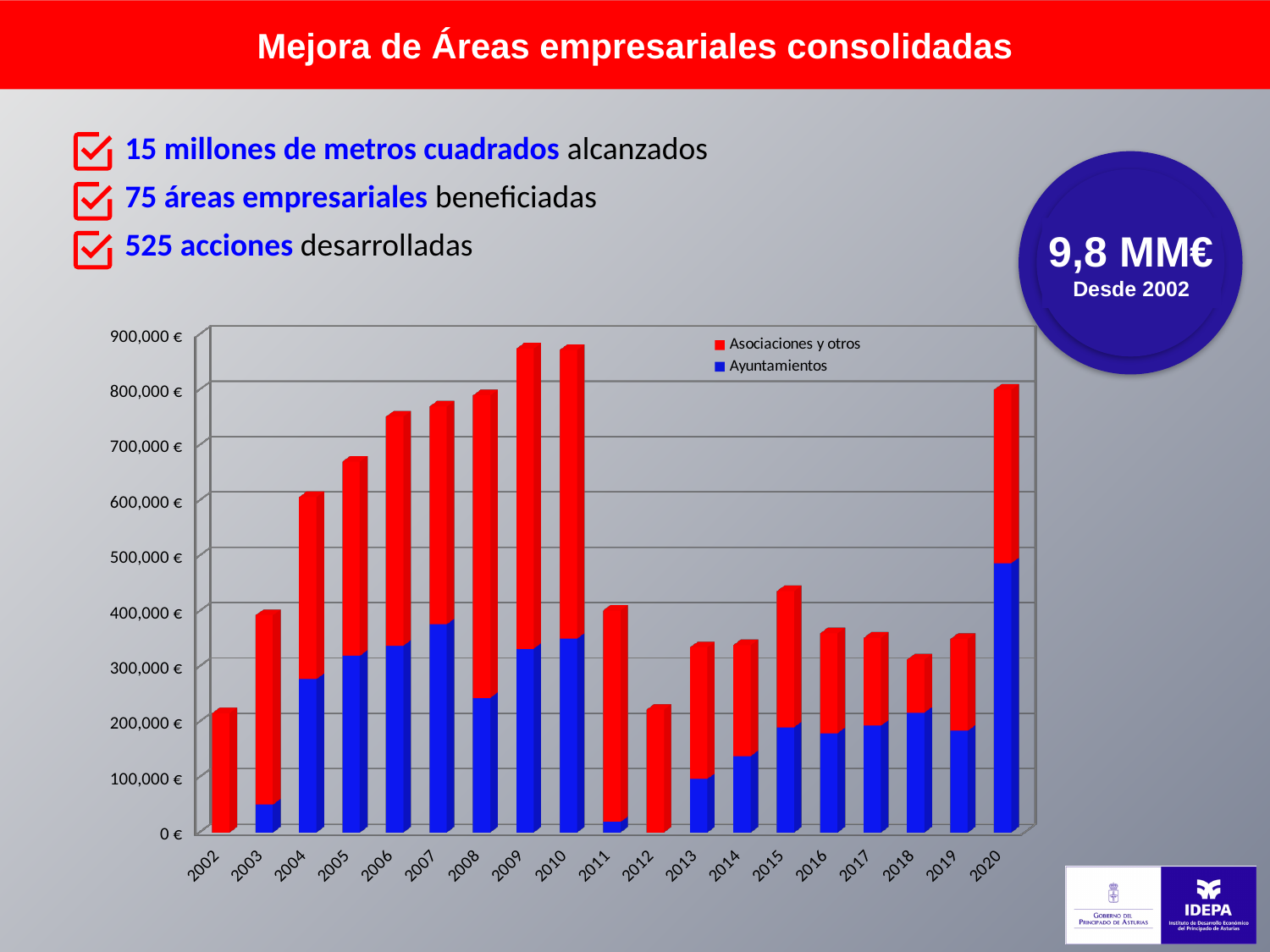
Which series is shown in red in the chart? Asociaciones y otros Is the total value for 2020 greater or less than 700,000 €? greater What kind of chart is shown on the slide? Stacked bar chart Do the total values rise or fall from 2004 to 2009? rise Which year has the larger total bar, 2020 or 2011? 2020 Is the total value for 2004 greater or less than 500,000 €? greater How many years are shown on the x axis of the chart? 19 Which series is shown in blue in the chart? Ayuntamientos Is the total value for 2012 greater or less than 300,000 €? less How many series does the chart legend list? 2 Which year has the larger total bar, 2015 or 2018? 2015